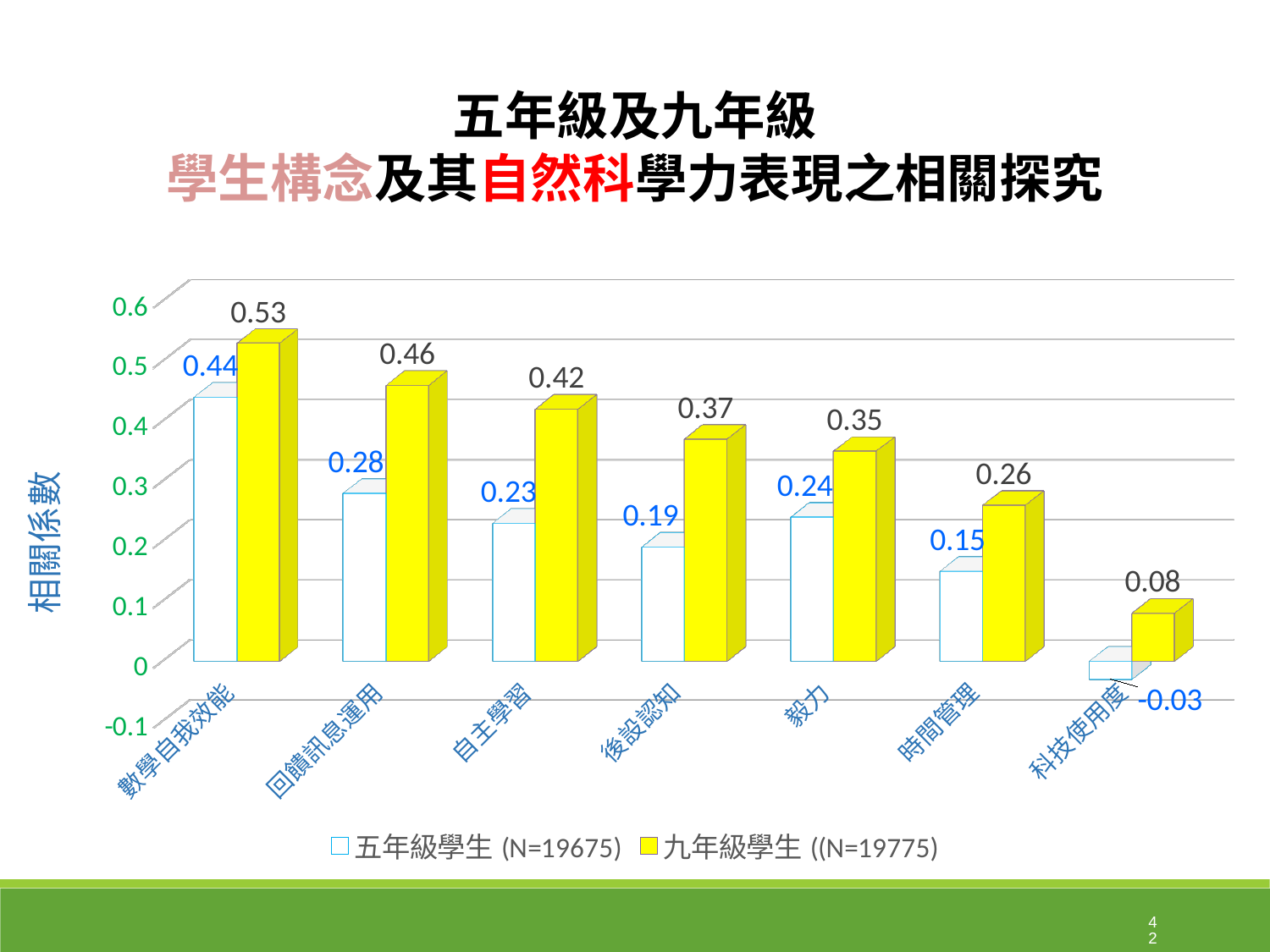
How many categories are shown on the x axis? 7 Which category has the lowest value for 五年級學生? 科技使用度 What is the difference between the 九年級學生 and 五年級學生 values for 自主學習? 0.19 What kind of chart is shown on the slide? Bar chart How many series does the legend list? 2 What is the value for 九年級學生 in the 數學自我效能 category? 0.53 Do the 九年級學生 values rise or fall from left to right along the x axis? Fall What is the value for 五年級學生 in the 科技使用度 category? -0.03 What is the value for 五年級學生 in the 後設認知 category? 0.19 What is the value for 九年級學生 in the 時間管理 category? 0.26 Which is larger for 毅力: the 五年級學生 value or the 九年級學生 value? 九年級學生 Which category has the highest value for 九年級學生? 數學自我效能